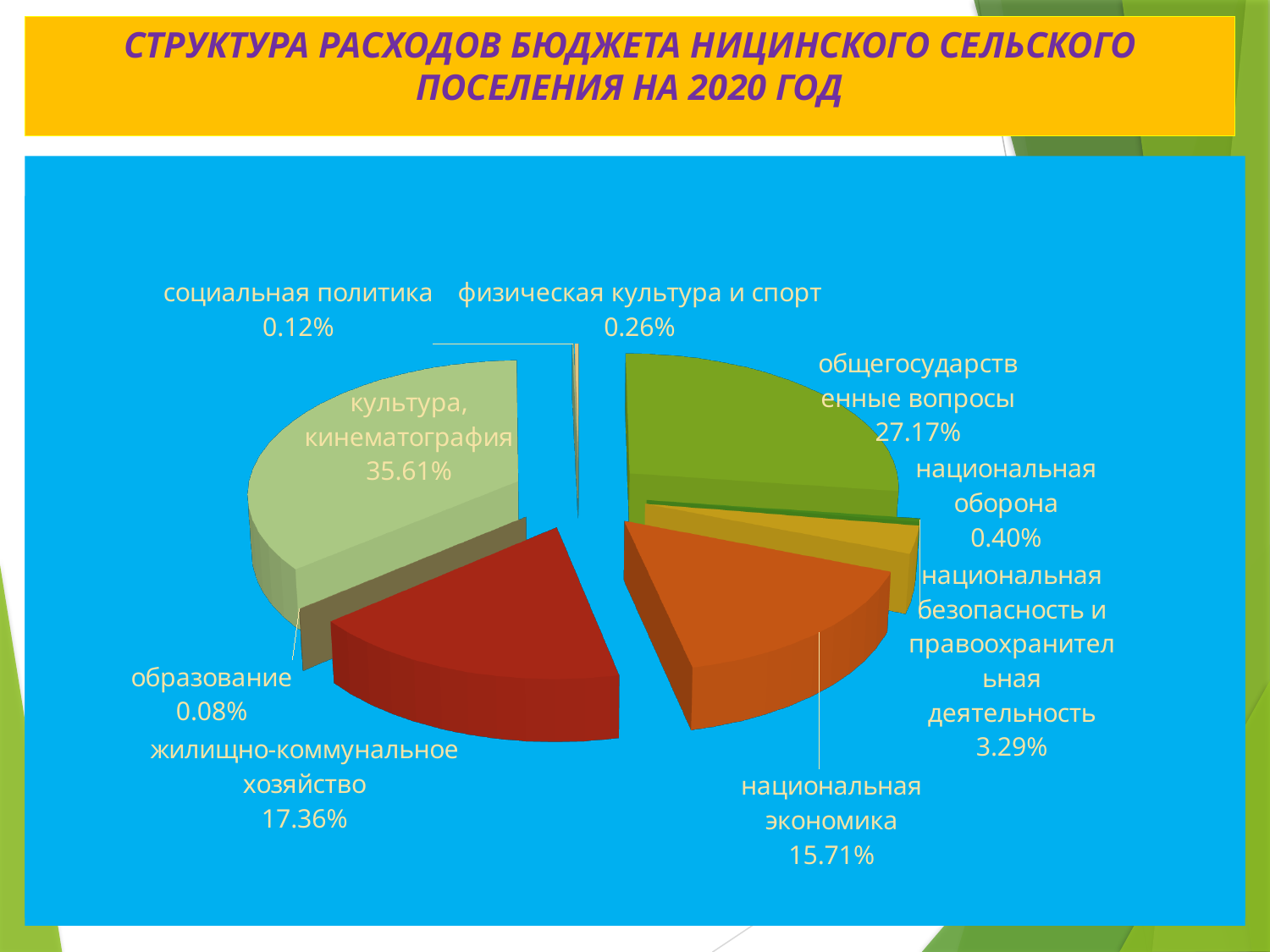
Which is larger: the share for жилищно-коммунальное хозяйство or for национальная экономика? жилищно-коммунальное хозяйство Which category has the smallest share of the pie? образование What kind of chart is shown on the slide? pie chart What is the value for национальная экономика? 15.71% What is the title of the chart on the slide? СТРУКТУРА РАСХОДОВ БЮДЖЕТА НИЦИНСКОГО СЕЛЬСКОГО ПОСЕЛЕНИЯ НА 2020 ГОД What is the value shown for общегосударственные вопросы? 27.17% What share is shown for национальная безопасность и правоохранительная деятельность? 3.29% What share of the budget expenditures goes to культура, кинематография? 35.61% How many categories are shown in the pie chart? 9 What is the difference between the shares of общегосударственные вопросы and национальная экономика? 11.46% What percentage is shown for жилищно-коммунальное хозяйство? 17.36% Which category has the largest share of the pie? культура, кинематография